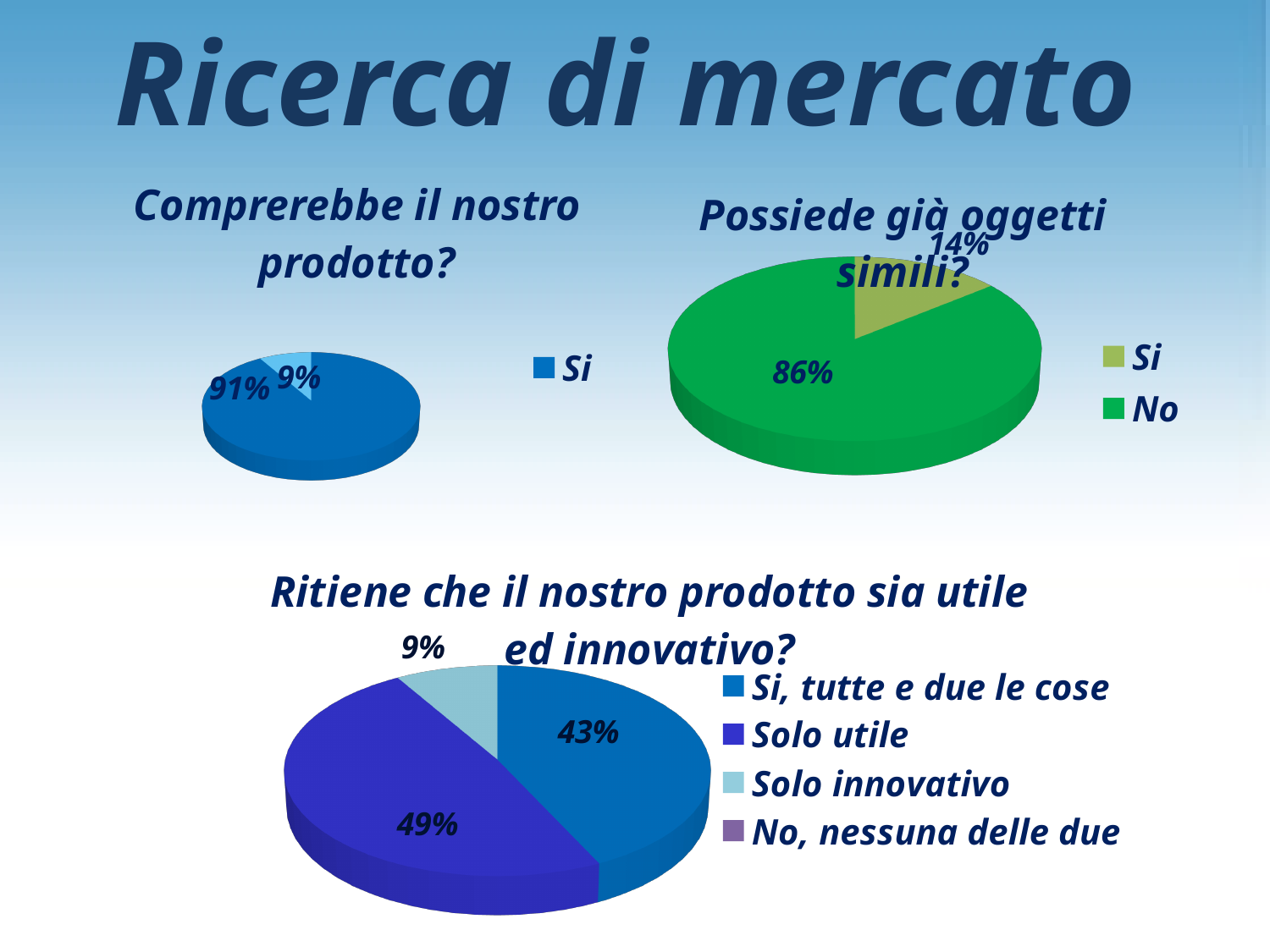
On the chart titled "Ritiene che il nostro prodotto sia utile ed innovativo?", how many entries does the legend list? 4 On the chart titled "Ritiene che il nostro prodotto sia utile ed innovativo?", which category has the smallest visible slice? Solo innovativo On the chart titled "Ritiene che il nostro prodotto sia utile ed innovativo?", what percentage is shown for "Si, tutte e due le cose"? 43% On the chart titled "Ritiene che il nostro prodotto sia utile ed innovativo?", what percentage is shown for "Solo innovativo"? 9% On the chart titled "Possiede già oggetti simili?", what percentage is shown for "No"? 86% On the chart titled "Possiede già oggetti simili?", what is the difference between the "No" and "Si" percentages? 72% On the chart titled "Possiede già oggetti simili?", what percentage is shown for "Si"? 14% On the chart titled "Comprerebbe il nostro prodotto?", what percentage is shown for "Si"? 91% On the chart titled "Ritiene che il nostro prodotto sia utile ed innovativo?", what percentage is shown for "Solo utile"? 49% On the chart titled "Possiede già oggetti simili?", which category has the largest slice? No On the chart titled "Ritiene che il nostro prodotto sia utile ed innovativo?", which is larger: "Solo utile" or "Si, tutte e due le cose"? Solo utile What kind of chart is used for "Comprerebbe il nostro prodotto?"? Pie chart